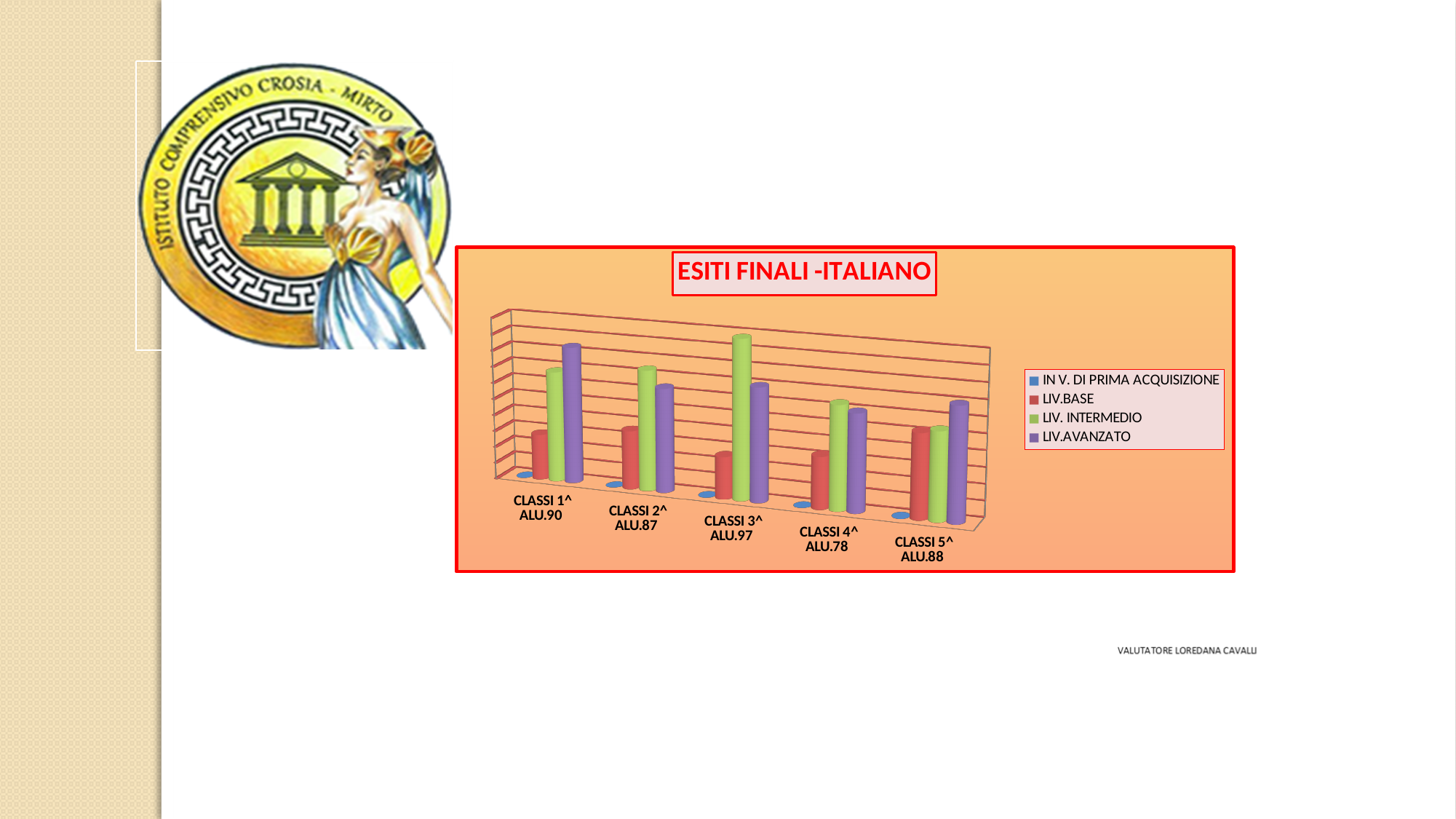
For CLASSI 1^ ALU.90, which is larger: LIV. INTERMEDIO or LIV.AVANZATO? LIV.AVANZATO How many class categories are shown along the x axis? 5 Which class has the highest LIV.AVANZATO bar? CLASSI 1^ ALU.90 For CLASSI 3^ ALU.97, which is larger: LIV. INTERMEDIO or LIV.AVANZATO? LIV. INTERMEDIO For CLASSI 2^ ALU.87, which is larger: LIV.BASE or LIV. INTERMEDIO? LIV. INTERMEDIO Which series has the lowest bars across all classes? IN V. DI PRIMA ACQUISIZIONE Which class has the highest LIV. INTERMEDIO bar? CLASSI 3^ ALU.97 Which series is shown in green in the legend? LIV. INTERMEDIO What is the title of the chart? ESITI FINALI -ITALIANO What kind of chart is shown on the slide? bar chart Which class has the highest LIV.BASE bar? CLASSI 5^ ALU.88 How many series does the legend list? 4